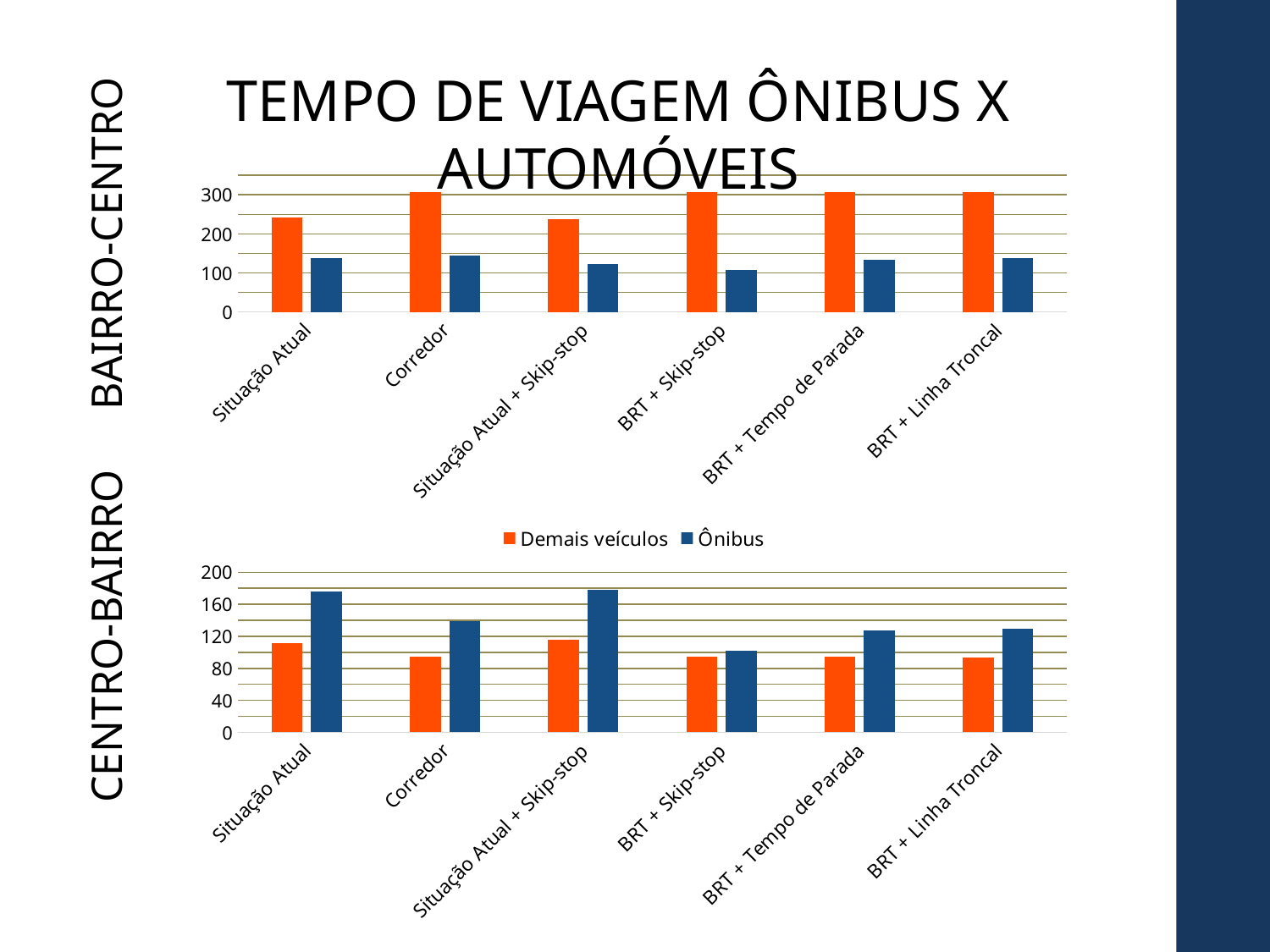
How many series does the legend list? 2 In the bottom chart (CENTRO-BAIRRO), which category has the lowest Ônibus value? BRT + Skip-stop In the top chart (BAIRRO-CENTRO), is the Ônibus value for BRT + Skip-stop greater or less than 200? less In the bottom chart (CENTRO-BAIRRO), is the Ônibus value for Situação Atual greater or less than 160? greater In the top chart (BAIRRO-CENTRO), which category has the lowest Ônibus value? BRT + Skip-stop In the bottom chart (CENTRO-BAIRRO), is the Demais veículos value for Corredor greater or less than 120? less What type of chart is the top chart (BAIRRO-CENTRO)? bar chart How many categories are shown on the x axis of the bottom chart (CENTRO-BAIRRO)? 6 In the bottom chart (CENTRO-BAIRRO), for Situação Atual, which series has the larger value: Demais veículos or Ônibus? Ônibus Which series is shown in orange in the legend? Demais veículos In the top chart (BAIRRO-CENTRO), for Situação Atual, which series has the larger value: Demais veículos or Ônibus? Demais veículos